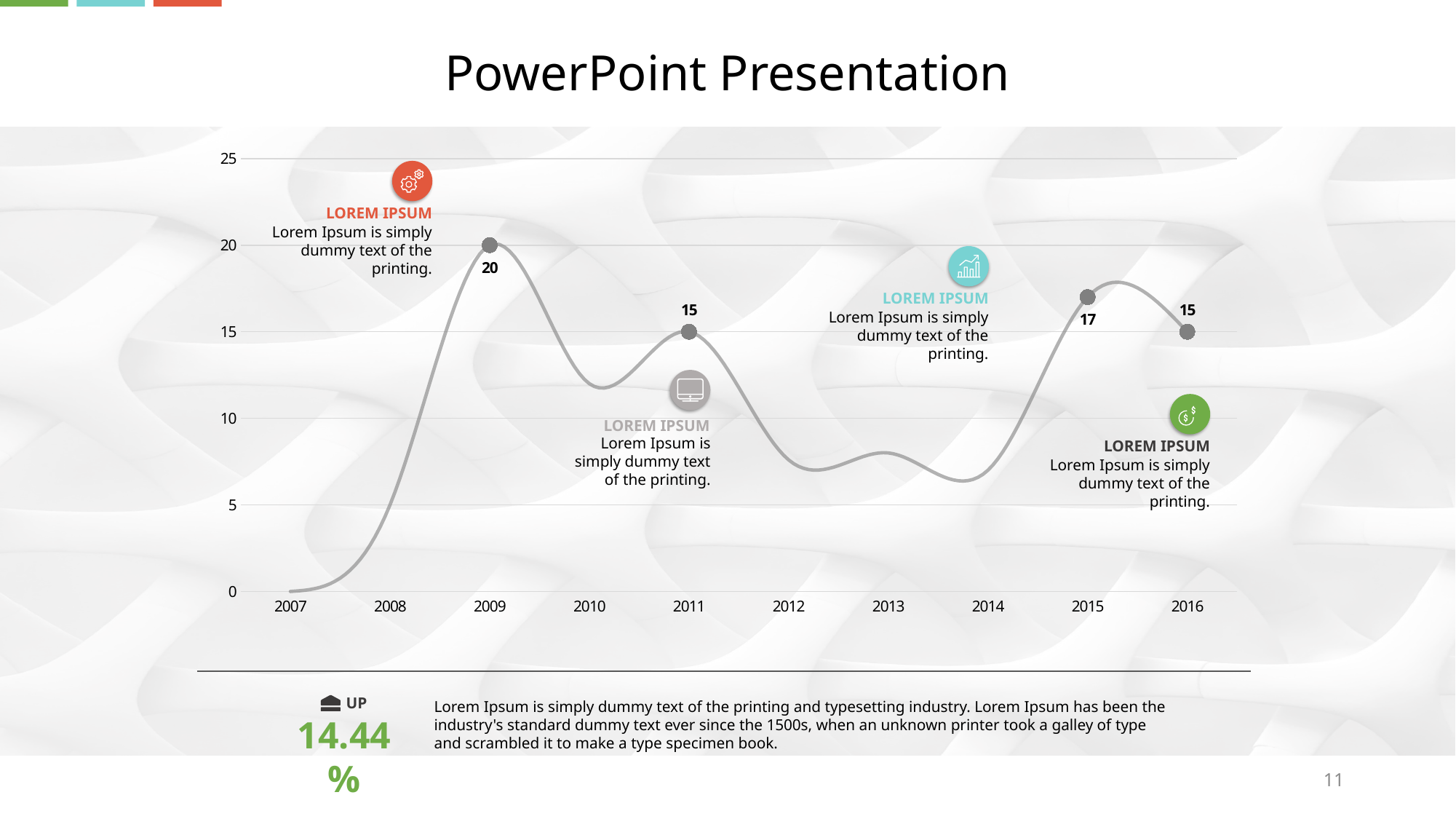
Is the value for 2010 greater or less than 15? less What is the value for 2016? 15 What is the value for 2015? 17 What is the difference between the values for 2009 and 2011? 5 How many years are shown on the x axis? 10 Which year has the highest value on the chart? 2009 What is the value for 2009? 20 What kind of chart is shown on the slide? line chart What is the value for 2011? 15 Which is larger, the value for 2009 or the value for 2015? 2009 Is the value for 2012 greater or less than 10? less What is the difference between the values for 2015 and 2016? 2